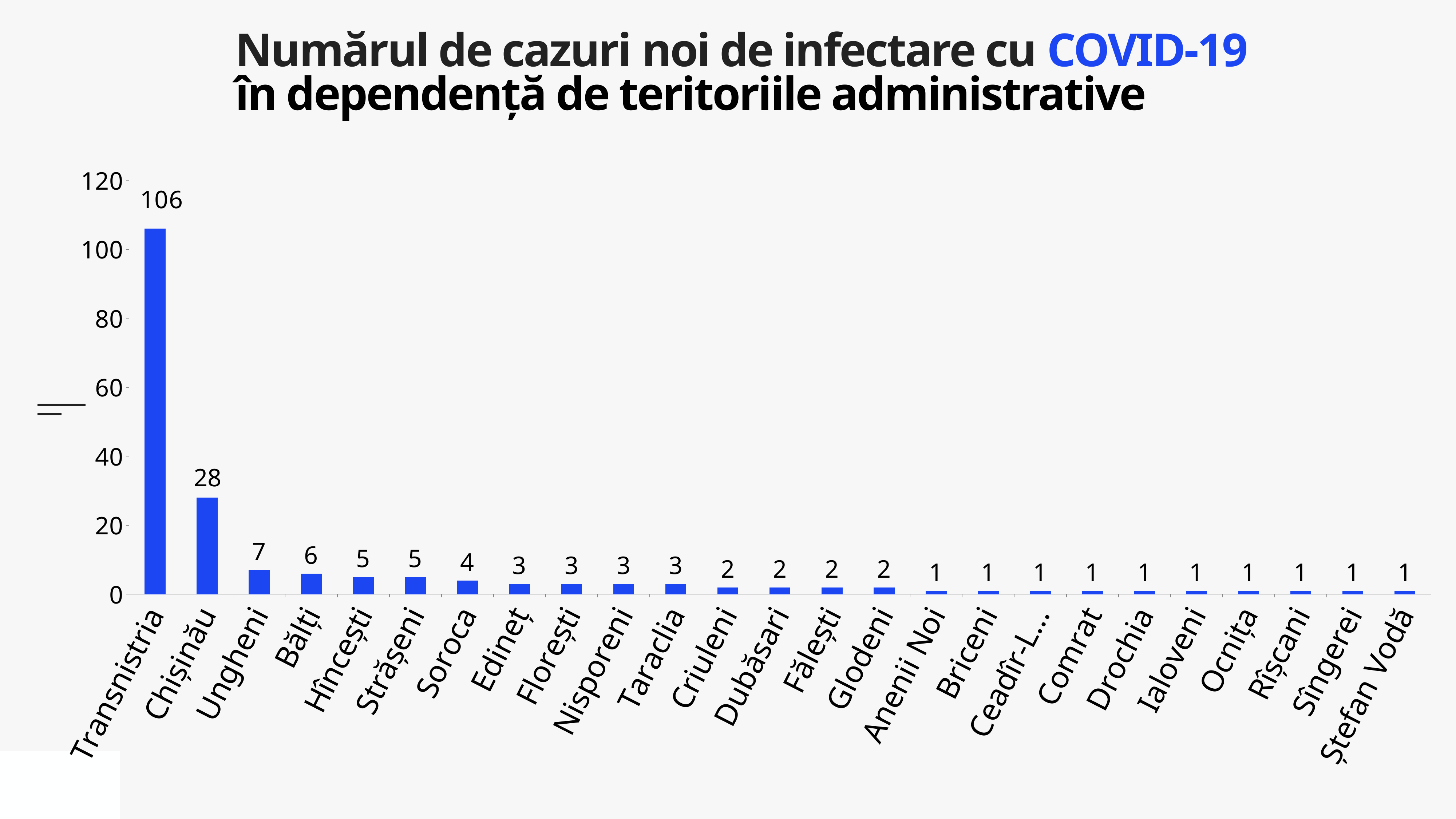
What is the value for Transnistria? 106 How many categories are shown on the x axis? 25 What is the difference between the values for Ungheni and Bălți? 1 Which is larger, the value for Hîncești or the value for Soroca? Hîncești What is the value for Glodeni? 2 What is the value for Soroca? 4 Is the value for Chișinău greater or less than 40? less Which category has the highest value? Transnistria What is the value for Chișinău? 28 What is the difference between the values for Transnistria and Chișinău? 78 What is the value for Ungheni? 7 What kind of chart is shown on the slide? bar chart